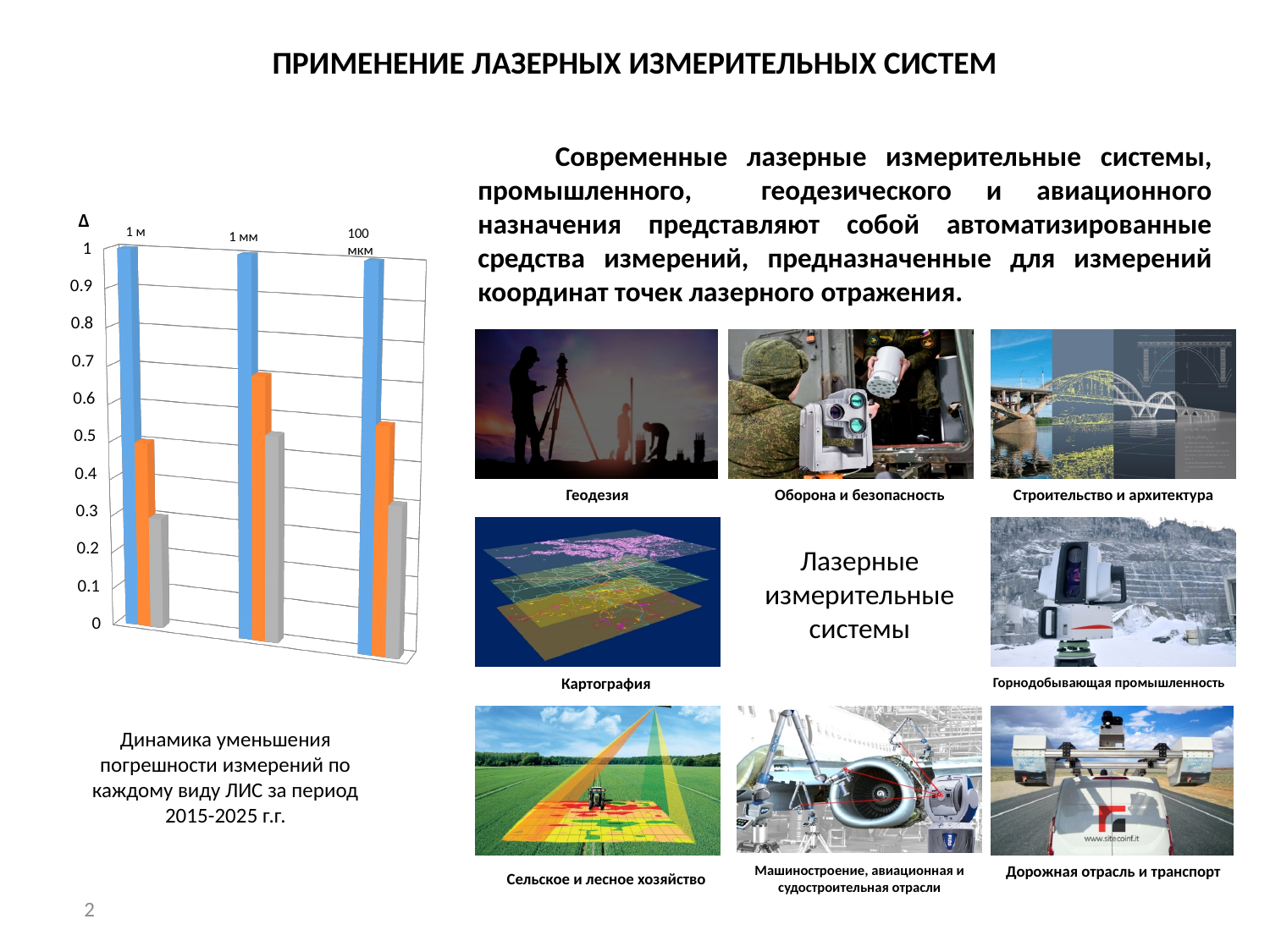
How many categories are shown on the x axis of the bar chart? 3 How many bars are plotted for each category in the bar chart? 3 In the bar chart, is the value of the blue bar for the '1 м' category greater or less than 0.8? greater In the bar chart, is the value of the orange bar for the '1 мм' category greater or less than 0.5? greater What kind of chart is shown on the left of the slide? bar chart In the bar chart, is the value of the gray bar for the '1 м' category greater or less than 0.5? less In the bar chart, which is larger for the '1 м' category: the blue bar or the orange bar? the blue bar In the bar chart, which is larger for the '1 м' category: the orange bar or the gray bar? the orange bar What caption is written below the bar chart? Динамика уменьшения погрешности измерений по каждому виду ЛИС за период 2015-2025 г.г. In the bar chart, for which category is the gray bar the highest? 1 мм What label is shown at the top of the vertical axis of the bar chart? Δ